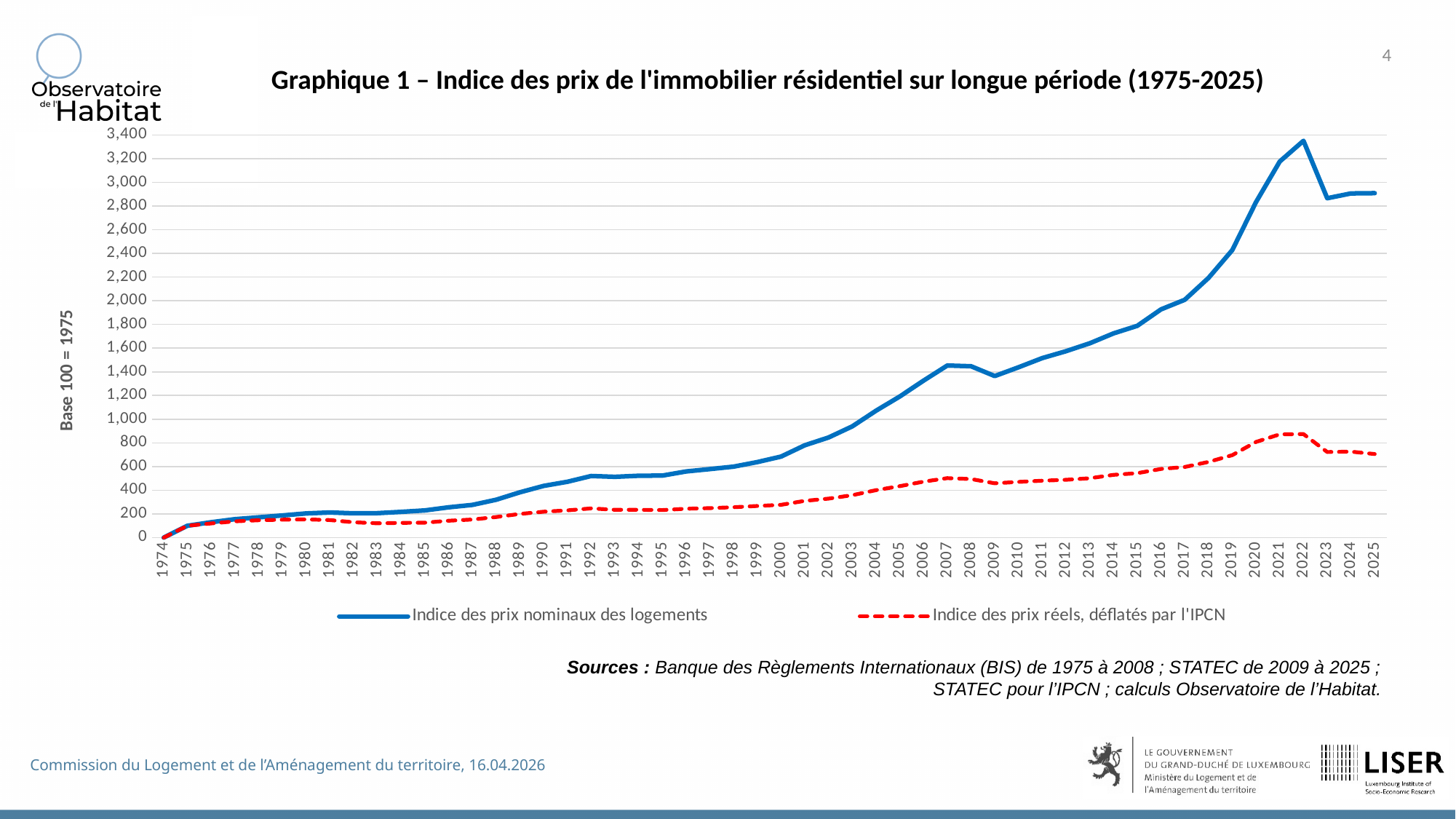
Does the 'Indice des prix nominaux des logements' rise or fall between 2022 and 2023? Fall Is the value of the 'Indice des prix réels, déflatés par l'IPCN' in 2022 greater or less than 1,000? less In which year does the 'Indice des prix nominaux des logements' reach its highest value? 2022 Is the value of the 'Indice des prix nominaux des logements' in 2022 greater or less than 3,200? greater Is the value of the 'Indice des prix nominaux des logements' in 2018 greater or less than 2,000? greater What kind of chart is shown on the slide? Line chart In 2022, which series has the larger value: the nominal price index or the real price index? Indice des prix nominaux des logements What is the title of the chart? Graphique 1 – Indice des prix de l'immobilier résidentiel sur longue période (1975-2025) How many series does the legend list? 2 Which series is drawn as a red dashed line? Indice des prix réels, déflatés par l'IPCN